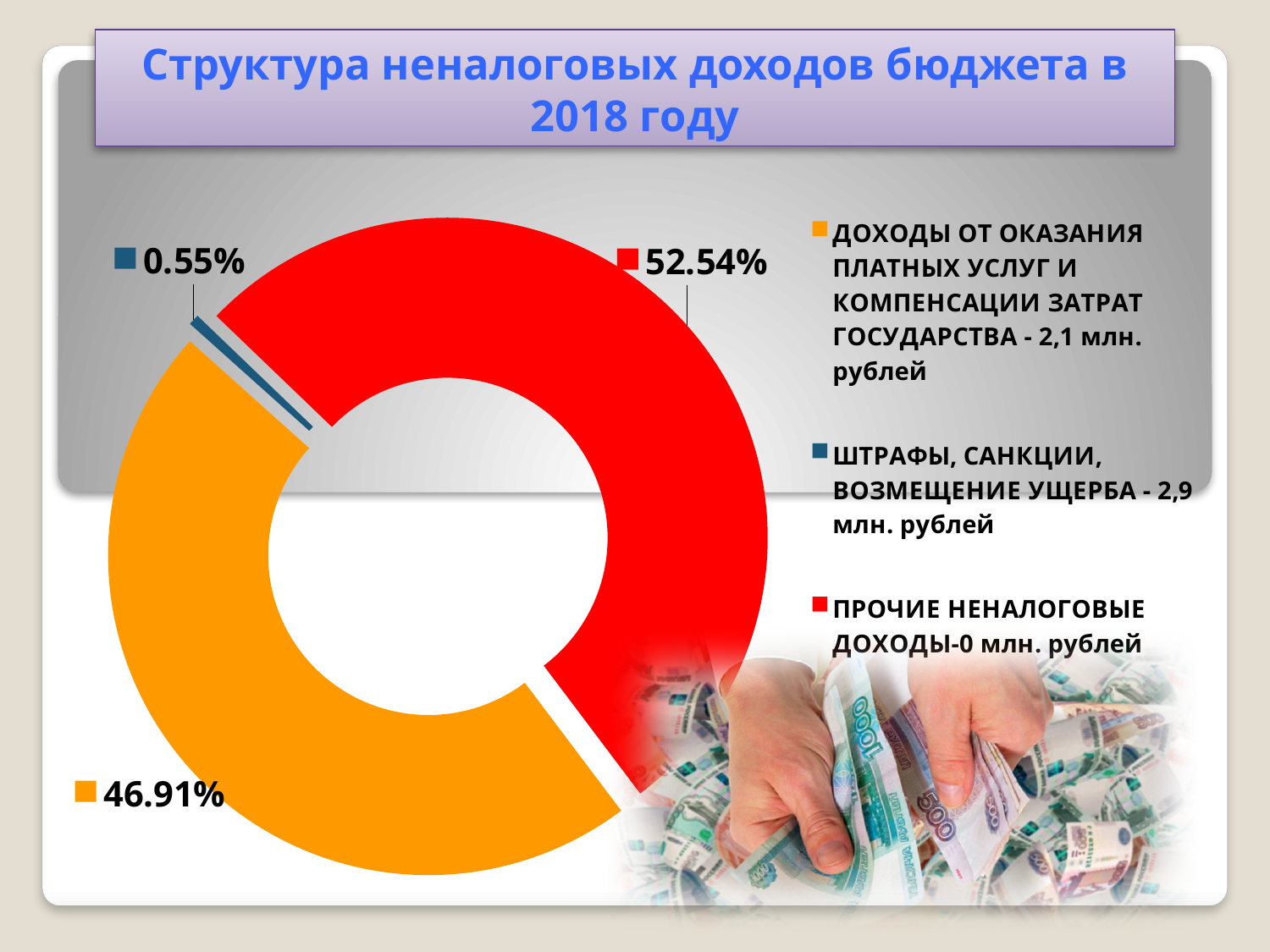
Which is larger: the share for ДОХОДЫ ОТ ОКАЗАНИЯ ПЛАТНЫХ УСЛУГ or the share for ПРОЧИЕ НЕНАЛОГОВЫЕ ДОХОДЫ? ПРОЧИЕ НЕНАЛОГОВЫЕ ДОХОДЫ What is the difference in percentage points between the red slice (52.54%) and the orange slice (46.91%)? 5.63 percentage points How many slices does the chart have? 3 What colour is the slice for ШТРАФЫ, САНКЦИИ, ВОЗМЕЩЕНИЕ УЩЕРБА? Blue What is the difference in percentage points between the orange slice (46.91%) and the blue slice (0.55%)? 46.36 percentage points What kind of chart is shown on the slide? Doughnut (pie) chart Which category has the smallest slice of the chart? ШТРАФЫ, САНКЦИИ, ВОЗМЕЩЕНИЕ УЩЕРБА What share of the chart is labelled for ДОХОДЫ ОТ ОКАЗАНИЯ ПЛАТНЫХ УСЛУГ И КОМПЕНСАЦИИ ЗАТРАТ ГОСУДАРСТВА (orange slice)? 46.91% What is the title of the slide? Структура неналоговых доходов бюджета в 2018 году What percentage is shown for ШТРАФЫ, САНКЦИИ, ВОЗМЕЩЕНИЕ УЩЕРБА (blue slice)? 0.55% What percentage is shown for ПРОЧИЕ НЕНАЛОГОВЫЕ ДОХОДЫ (red slice)? 52.54% Which category has the largest slice of the chart? ПРОЧИЕ НЕНАЛОГОВЫЕ ДОХОДЫ